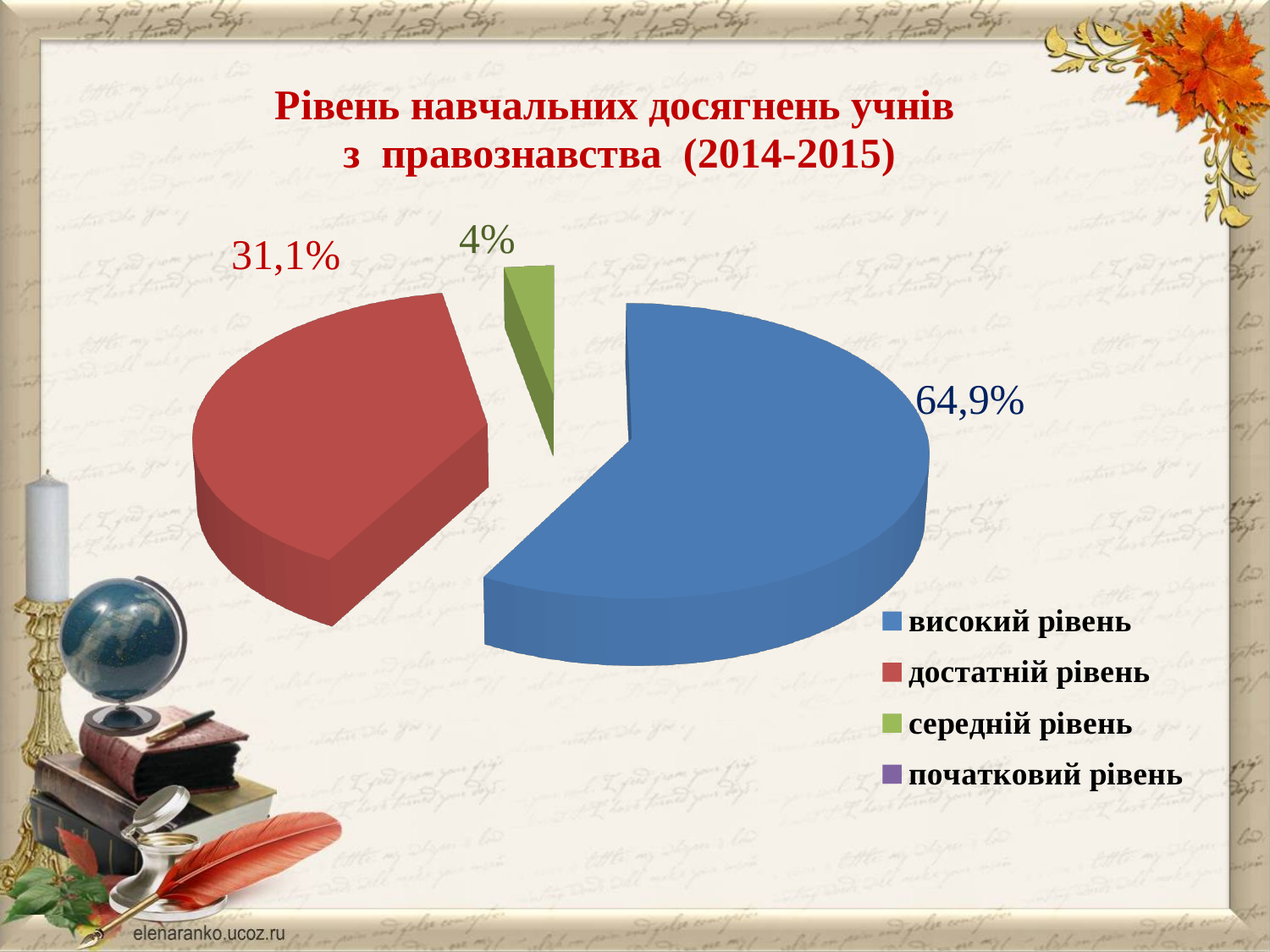
What is the difference between the percentages for достатній рівень and середній рівень? 27,1% Which is larger, the share for високий рівень or the share for достатній рівень? високий рівень What kind of chart is shown on the slide? pie chart Of the slices labelled with a percentage, which level has the smallest slice? середній рівень What percentage does the slice for високий рівень show? 64,9% What colour is the slice for високий рівень? blue How many slices are visible in the pie? 3 How many entries does the legend list? 4 What percentage does the slice for середній рівень show? 4% What percentage does the slice for достатній рівень show? 31,1% Which level has the largest slice of the pie? високий рівень What is the difference between the percentages for високий рівень and достатній рівень? 33,8%